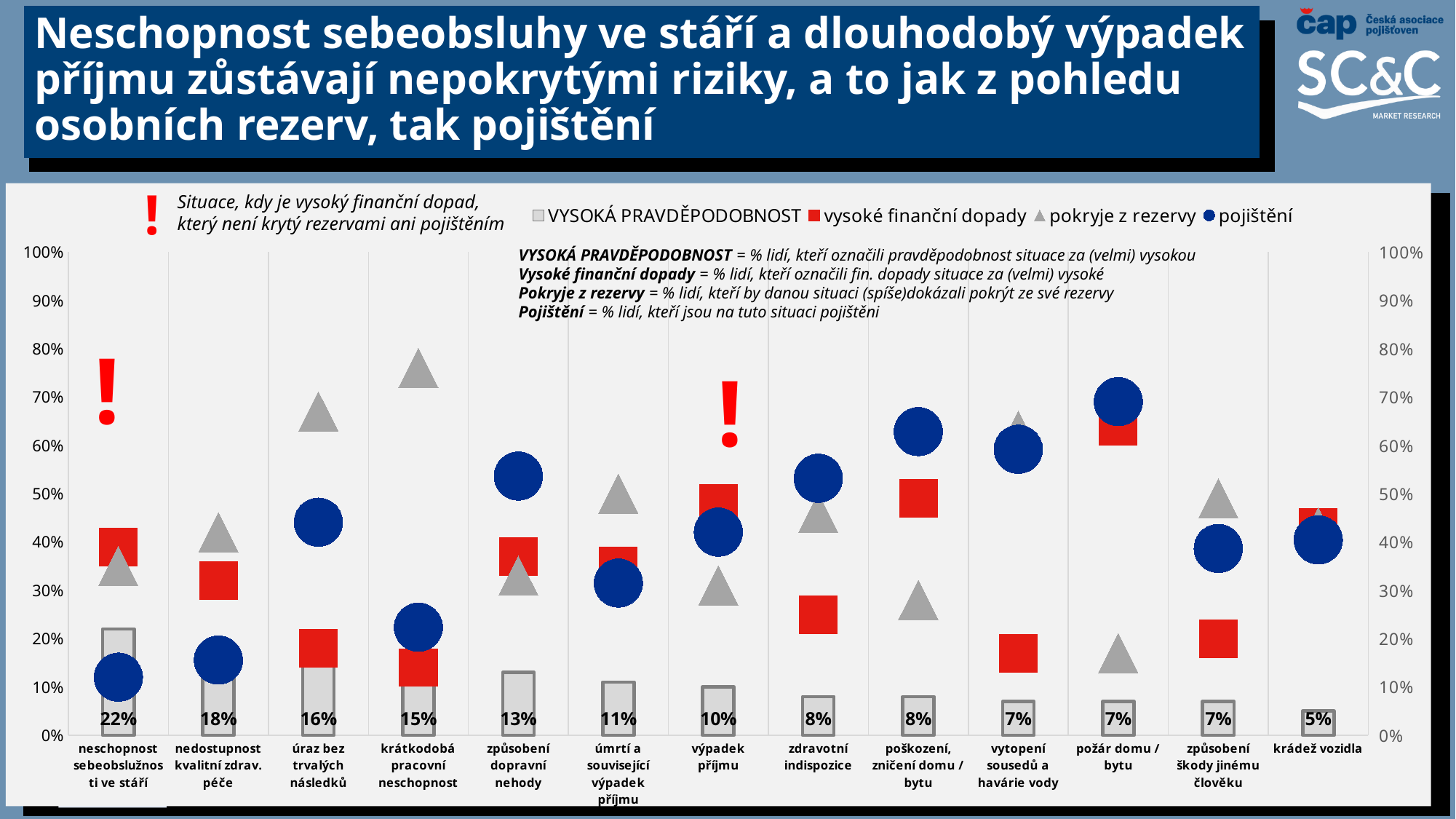
Is the pojištění value for 'požár domu / bytu' greater or less than 60%? greater Which has the larger pojištění value: 'neschopnost sebeobslužnosti ve stáří' or 'požár domu / bytu'? požár domu / bytu What is the VYSOKÁ PRAVDĚPODOBNOST value for 'výpadek příjmu'? 10% Which category has the highest VYSOKÁ PRAVDĚPODOBNOST value? neschopnost sebeobslužnosti ve stáří Is the pokryje z rezervy value for 'krátkodobá pracovní neschopnost' greater or less than 70%? greater How many series does the chart legend list? 4 What is the VYSOKÁ PRAVDĚPODOBNOST value for 'neschopnost sebeobslužnosti ve stáří'? 22% Which category has the lowest VYSOKÁ PRAVDĚPODOBNOST value? krádež vozidla What is the VYSOKÁ PRAVDĚPODOBNOST value for 'krádež vozidla'? 5% How many categories are shown on the x axis of the chart? 13 What is the difference between the VYSOKÁ PRAVDĚPODOBNOST values for 'neschopnost sebeobslužnosti ve stáří' and 'krádež vozidla'? 17% Do the VYSOKÁ PRAVDĚPODOBNOST values rise or fall from left to right along the x axis? fall